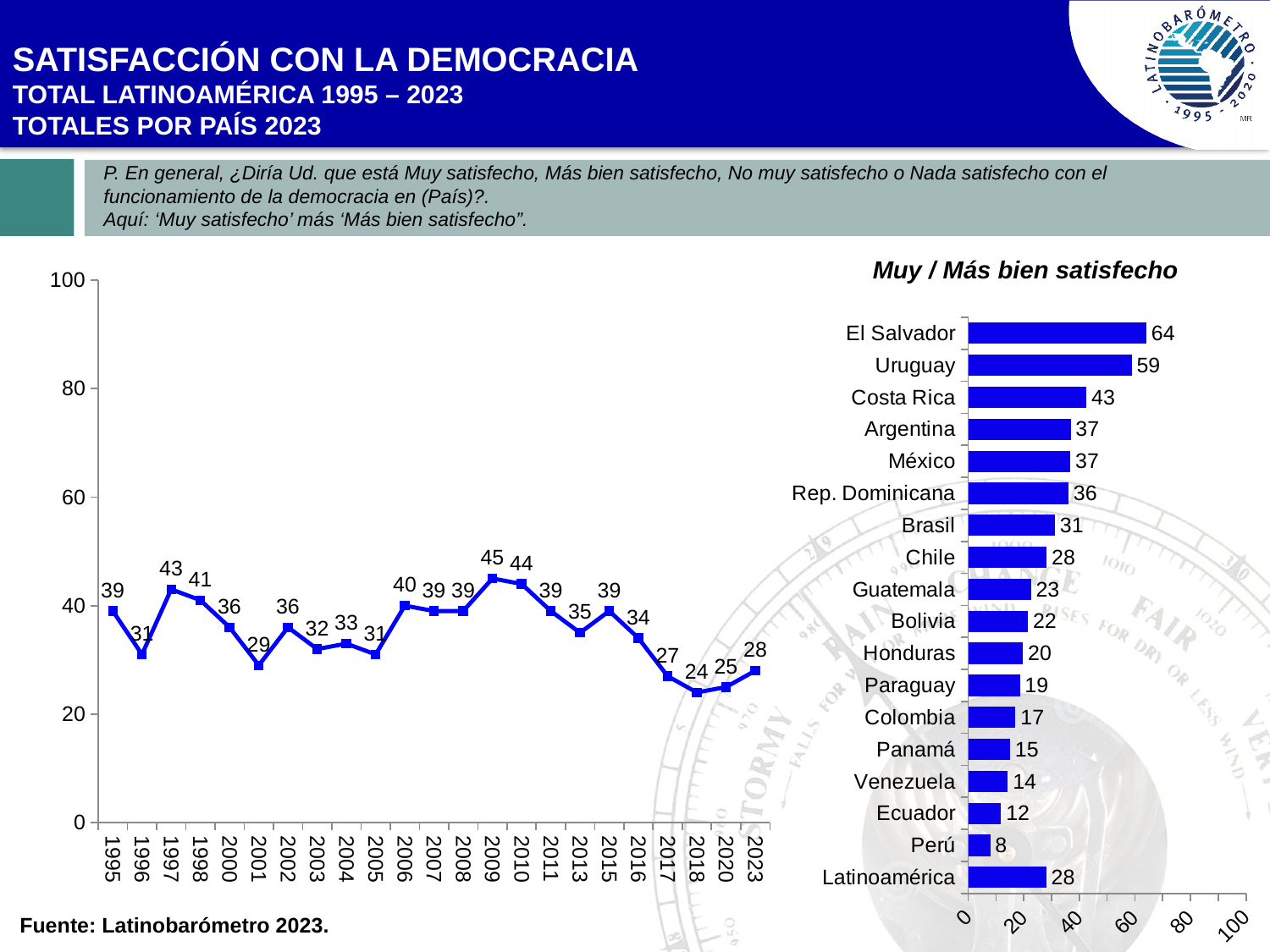
In the bar chart titled 'Muy / Más bien satisfecho', what is the difference between El Salvador and Uruguay? 5 In the line chart on the left, what is the value for 2009? 45 In the bar chart titled 'Muy / Más bien satisfecho', what is the value for Costa Rica? 43 What type of chart is the one on the right of the slide? Bar chart In the line chart on the left, which year has the lowest value? 2018 In the line chart on the left, what is the difference between the values for 1997 and 2001? 14 In the bar chart titled 'Muy / Más bien satisfecho', which country has the lowest value? Perú In the line chart on the left, is the value for 2006 larger than the value for 2016? Yes, 2006 (40) is larger than 2016 (34) In the line chart on the left, do the values rise or fall from 2015 to 2018? Fall In the bar chart titled 'Muy / Más bien satisfecho', how many bars are shown? 18 In the line chart on the left, how many data points are plotted? 23 In the bar chart titled 'Muy / Más bien satisfecho', which country has the highest value? El Salvador